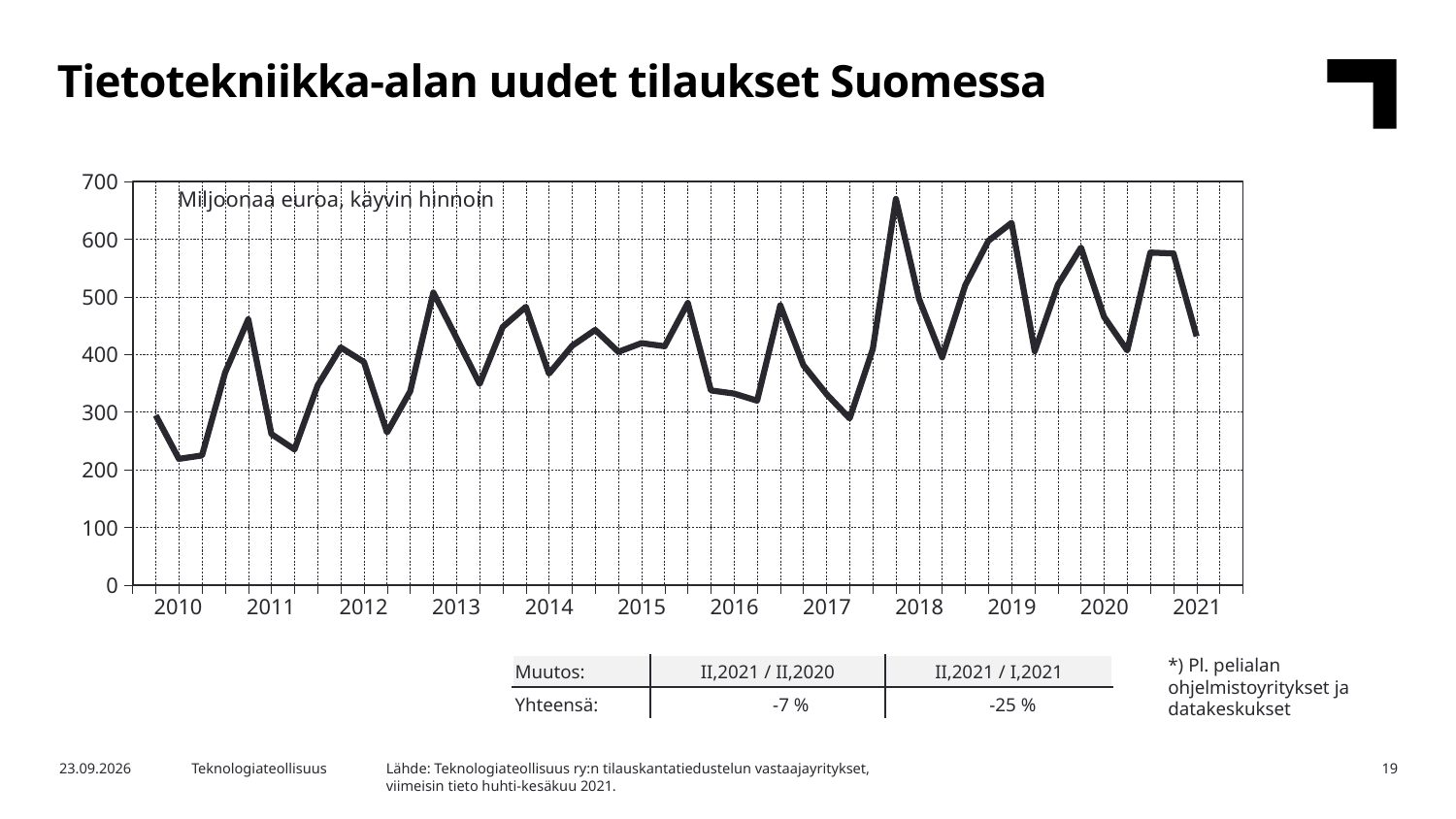
Is the highest peak of the line (in late 2017) greater or less than 600? greater Is the last plotted value in 2021 greater or less than 500? less Is the lowest point of the line (in 2010) greater or less than 300? less How many year labels are shown on the x axis of the chart? 12 In which year does the line reach its highest peak? 2018 What is the title of the chart on the slide? Tietotekniikka-alan uudet tilaukset Suomessa In what unit are the values on the chart expressed, according to the label inside the plot area? Miljoonaa euroa, käyvin hinnoin In which year does the line reach its lowest point? 2010 According to the table below the chart, what is the change (Muutos) for II,2021 / I,2021? -25 % What kind of chart is shown on the slide? line chart Does the line rise or fall between the last two plotted points in 2021? fall